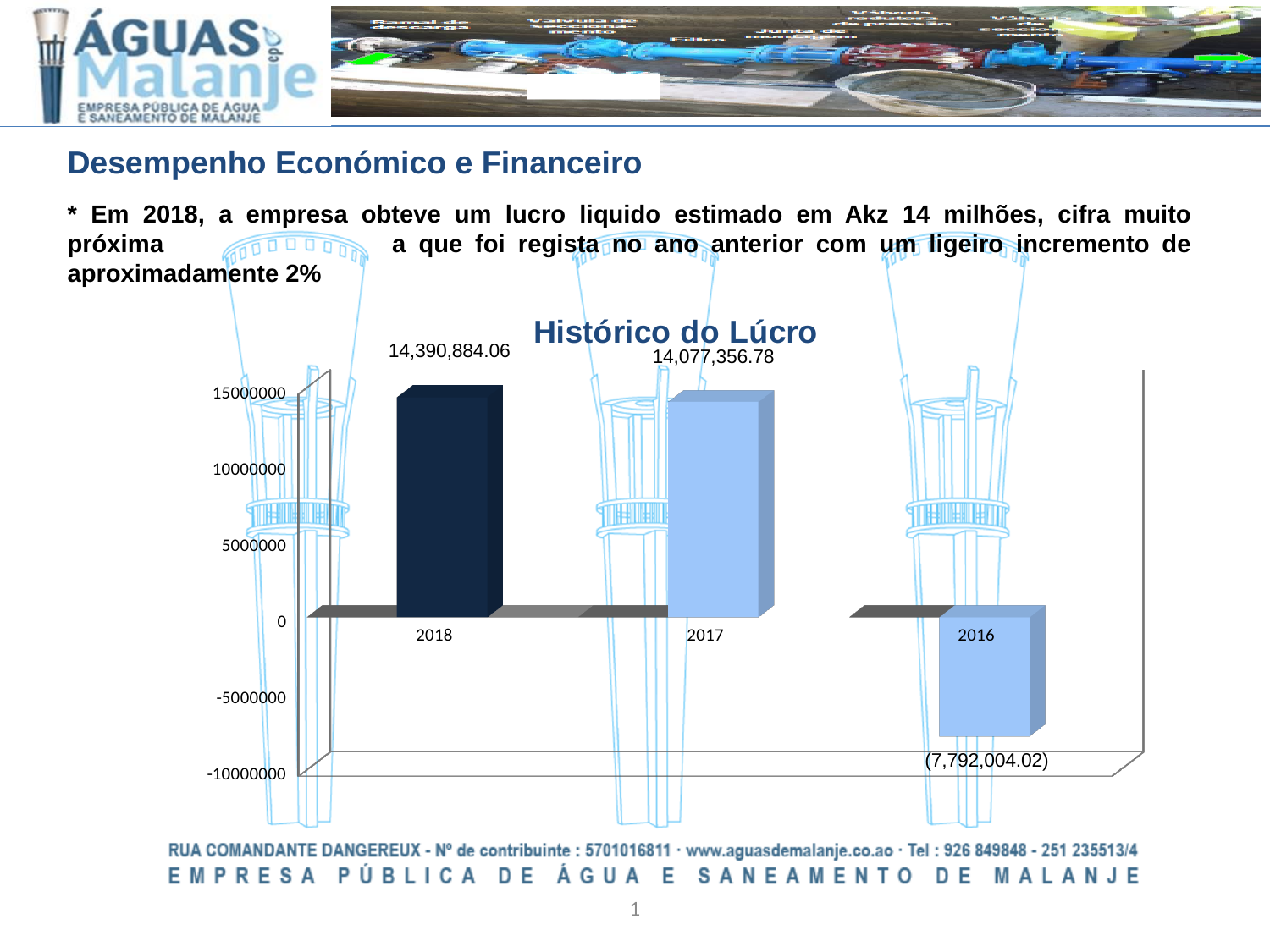
What is the title of the chart on the slide? Histórico do Lúcro Is the value for 2016 in the Histórico do Lúcro chart greater or less than -5000000? less What is the value shown for 2017 in the Histórico do Lúcro chart? 14,077,356.78 Which year has the lowest value in the Histórico do Lúcro chart? 2016 Which is larger in the Histórico do Lúcro chart, the value for 2018 or the value for 2017? 2018 Which year has the highest value in the Histórico do Lúcro chart? 2018 How many years are shown in the Histórico do Lúcro chart? 3 What is the value shown for 2016 in the Histórico do Lúcro chart? (7,792,004.02) What kind of chart is the Histórico do Lúcro chart? bar chart What is the value shown for 2018 in the Histórico do Lúcro chart? 14,390,884.06 Do the values in the Histórico do Lúcro chart rise or fall from left to right along the x axis? fall What is the difference between the 2018 and 2017 values in the Histórico do Lúcro chart? 313,527.28